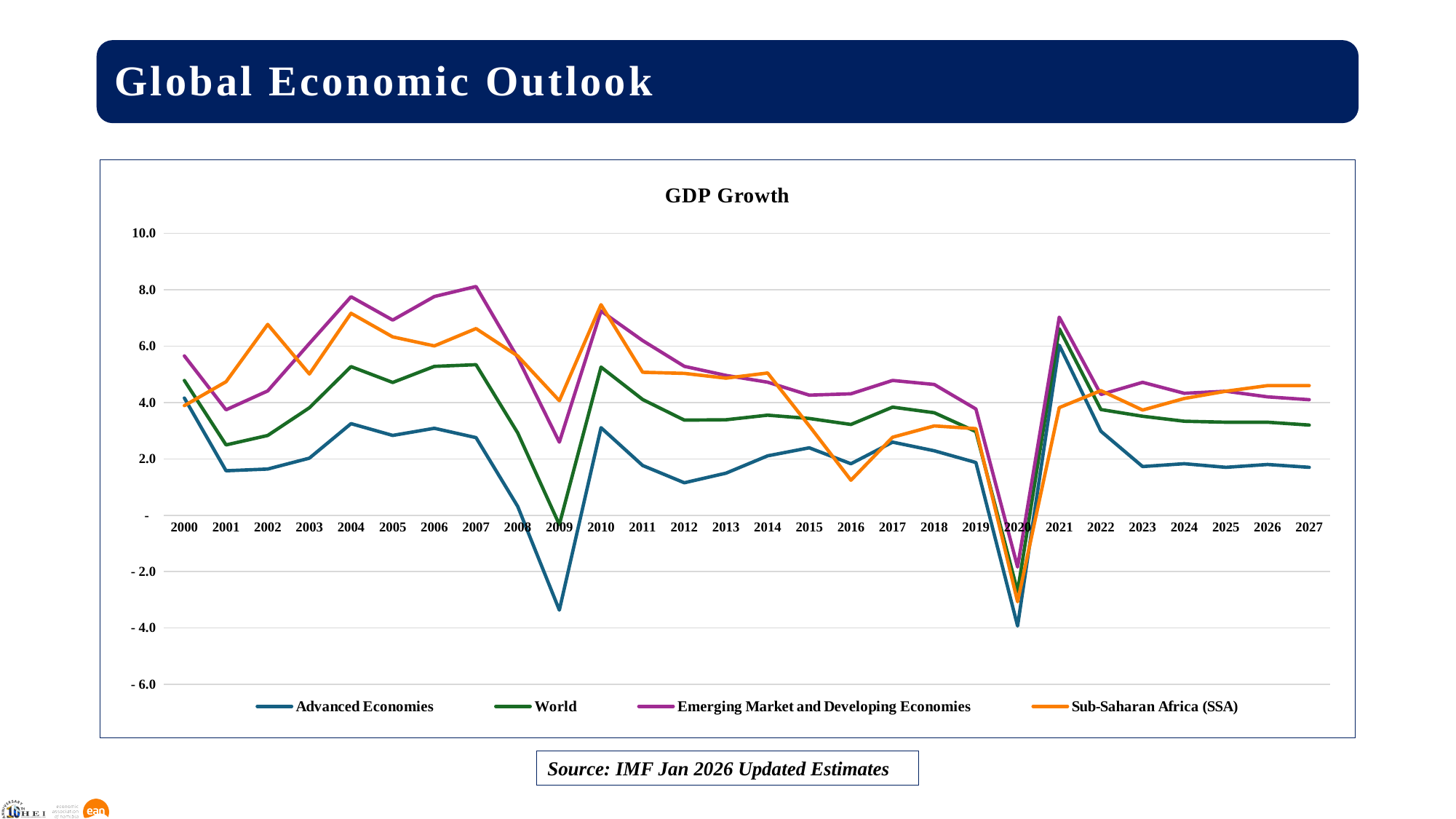
Is the value for Emerging Market and Developing Economies in 2007 greater or less than 6.0? greater How many years are plotted along the x axis of the GDP Growth chart? 28 What is the title of the chart? GDP Growth Is the value for World in 2020 greater or less than -2.0? less Is the value for Sub-Saharan Africa (SSA) in 2016 greater or less than 2.0? less Do the values for Advanced Economies rise or fall from 2010 to 2012? fall How many series does the legend of the GDP Growth chart list? 4 Which series has the lowest value in 2020? Advanced Economies In 2002, which is larger: the value for Sub-Saharan Africa (SSA) or for Emerging Market and Developing Economies? Sub-Saharan Africa (SSA) Which series has the highest value in 2007? Emerging Market and Developing Economies What kind of chart is shown on the slide? line chart